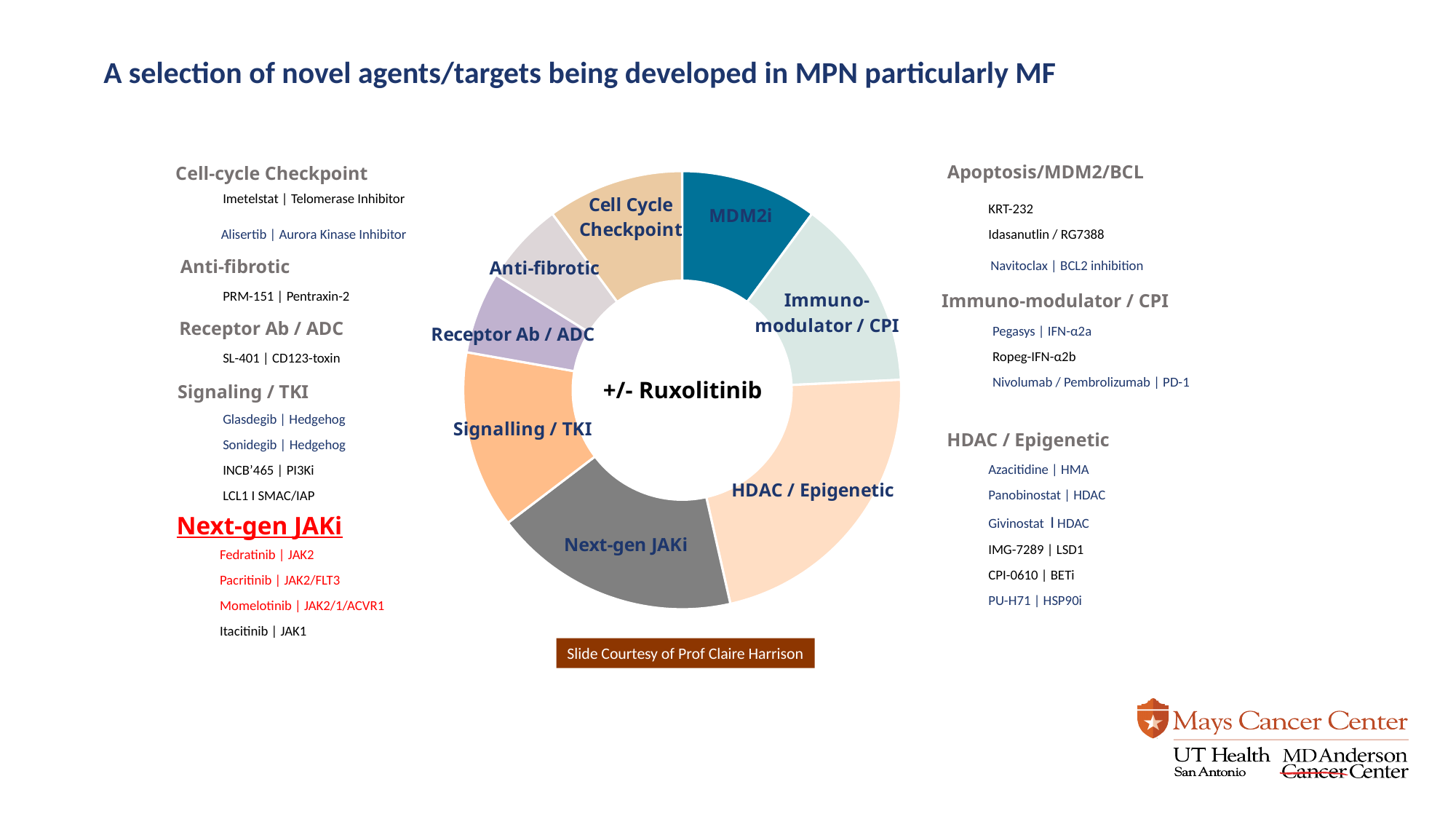
What kind of chart is shown on the slide? Pie (donut) chart Which segment of the donut chart is larger: Immuno-modulator / CPI or Anti-fibrotic? Immuno-modulator / CPI What text is written in the centre of the donut chart? +/- Ruxolitinib How many segments does the donut chart have? 8 Which segment of the donut chart is larger: Next-gen JAKi or Receptor Ab / ADC? Next-gen JAKi What is the title of the slide containing the donut chart? A selection of novel agents/targets being developed in MPN particularly MF Which segment of the donut chart is larger: Signalling / TKI or MDM2i? Signalling / TKI